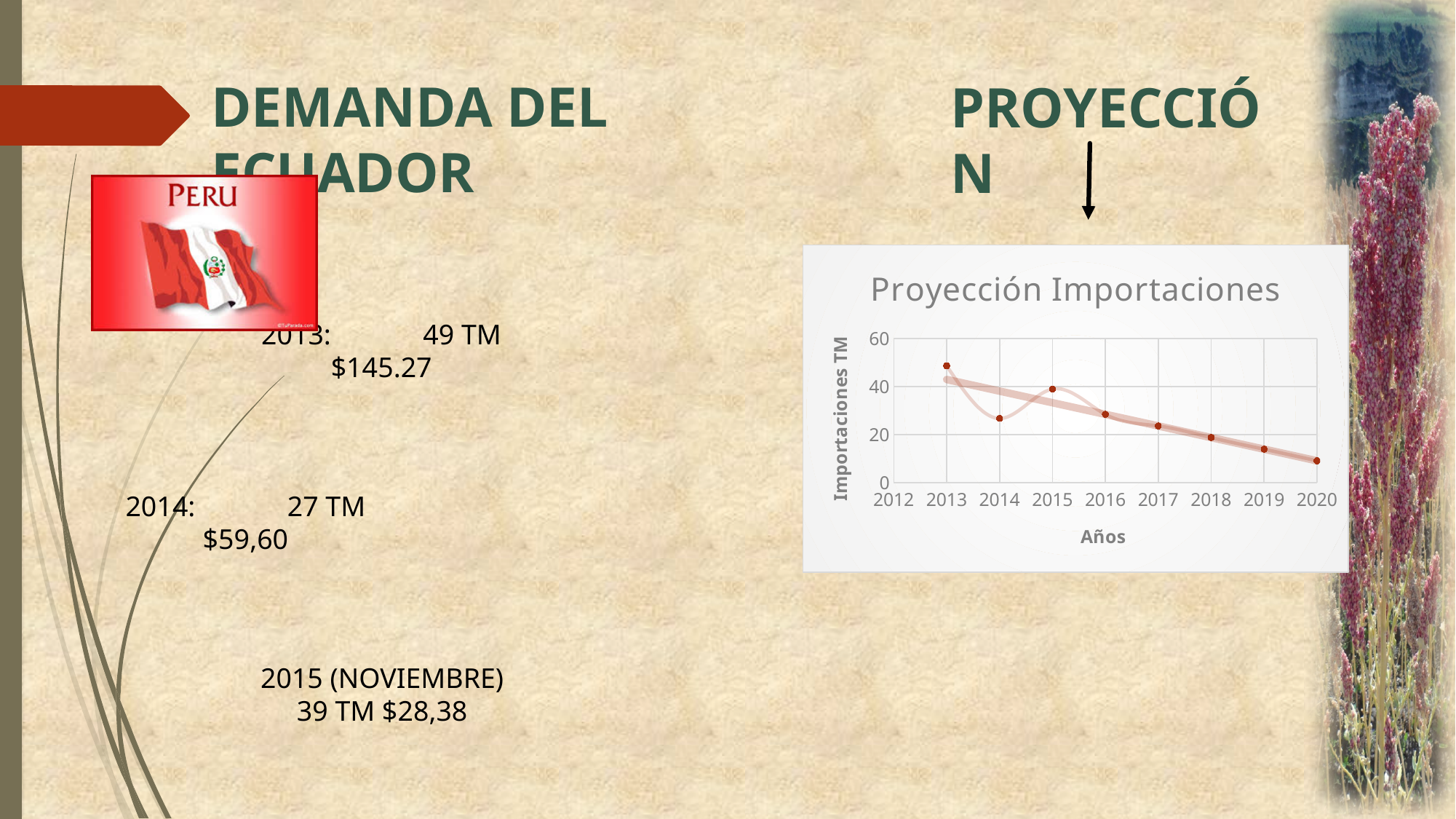
What is the title of the chart? Proyección Importaciones Which year has the highest value in the chart? 2013 Is the value for 2013 greater or less than 40? greater Is the value for 2019 greater or less than 20? less How many data points are plotted in the chart? 8 What kind of chart is shown on the slide? line chart Do the values in the chart generally rise or fall from 2013 to 2020? fall Is the value for 2020 greater or less than 20? less Which year has the larger value, 2015 or 2016? 2015 What is the label of the vertical axis of the chart? Importaciones TM Which year has the lowest value in the chart? 2020